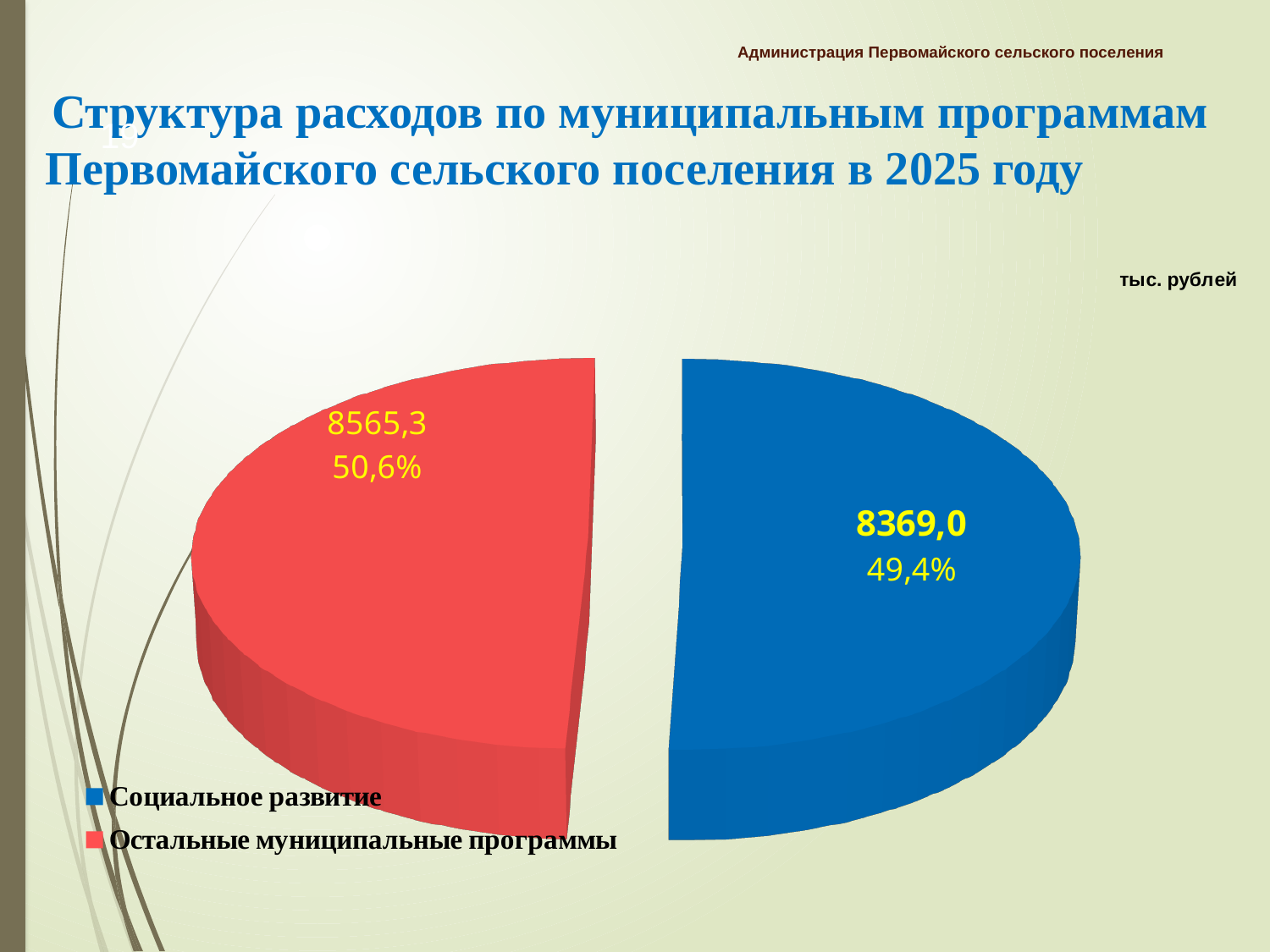
What colour is the slice for Социальное развитие? blue Which category has the smallest value? Социальное развитие Which category has the largest value? Остальные муниципальные программы How many slices does the pie chart have? 2 What kind of chart is shown on the slide? pie chart What share of the pie does Социальное развитие take? 49,4% What is the value for Остальные муниципальные программы? 8565,3 What is the difference between the values for Остальные муниципальные программы and Социальное развитие? 196,3 What is the value for Социальное развитие? 8369,0 Which is larger: the value for Социальное развитие or the value for Остальные муниципальные программы? Остальные муниципальные программы What share of the pie does Остальные муниципальные программы take? 50,6% In what units are the values on the chart given? тыс. рублей